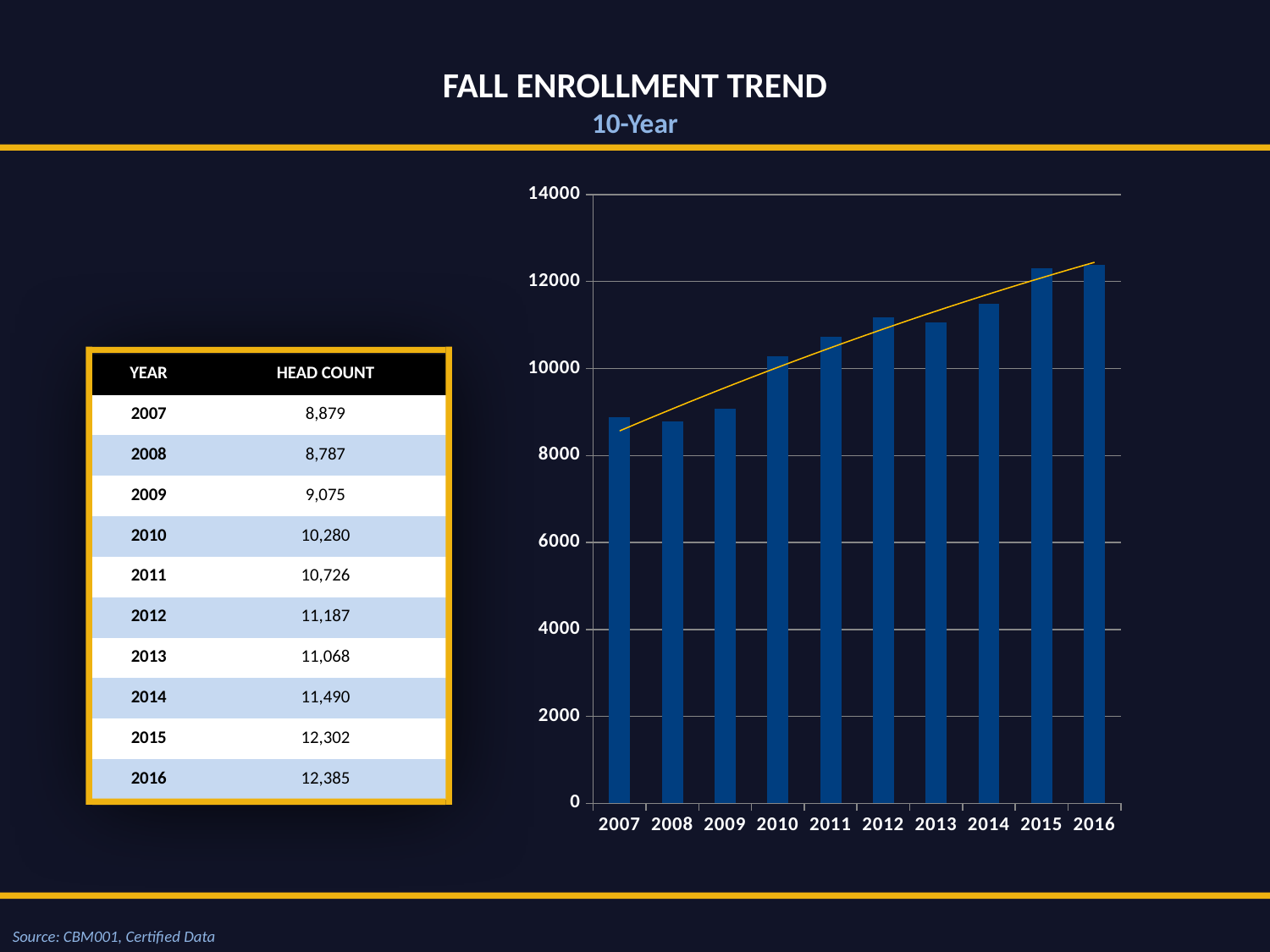
Which year has the lowest head count? 2008 Is the value for 2015 greater or less than 12000? greater Which year has a larger head count, 2012 or 2013? 2012 How many years are plotted on the x axis of the chart? 10 Do the head count values generally rise or fall from 2007 to 2016? rise What is the title of the slide containing the chart? FALL ENROLLMENT TREND What is the head count for 2010? 10,280 What is the head count for 2016? 12,385 What is the difference in head count between 2016 and 2007? 3,506 What kind of chart is shown on the slide? bar chart Which year has the highest head count? 2016 Is the value for 2009 greater or less than 10000? less